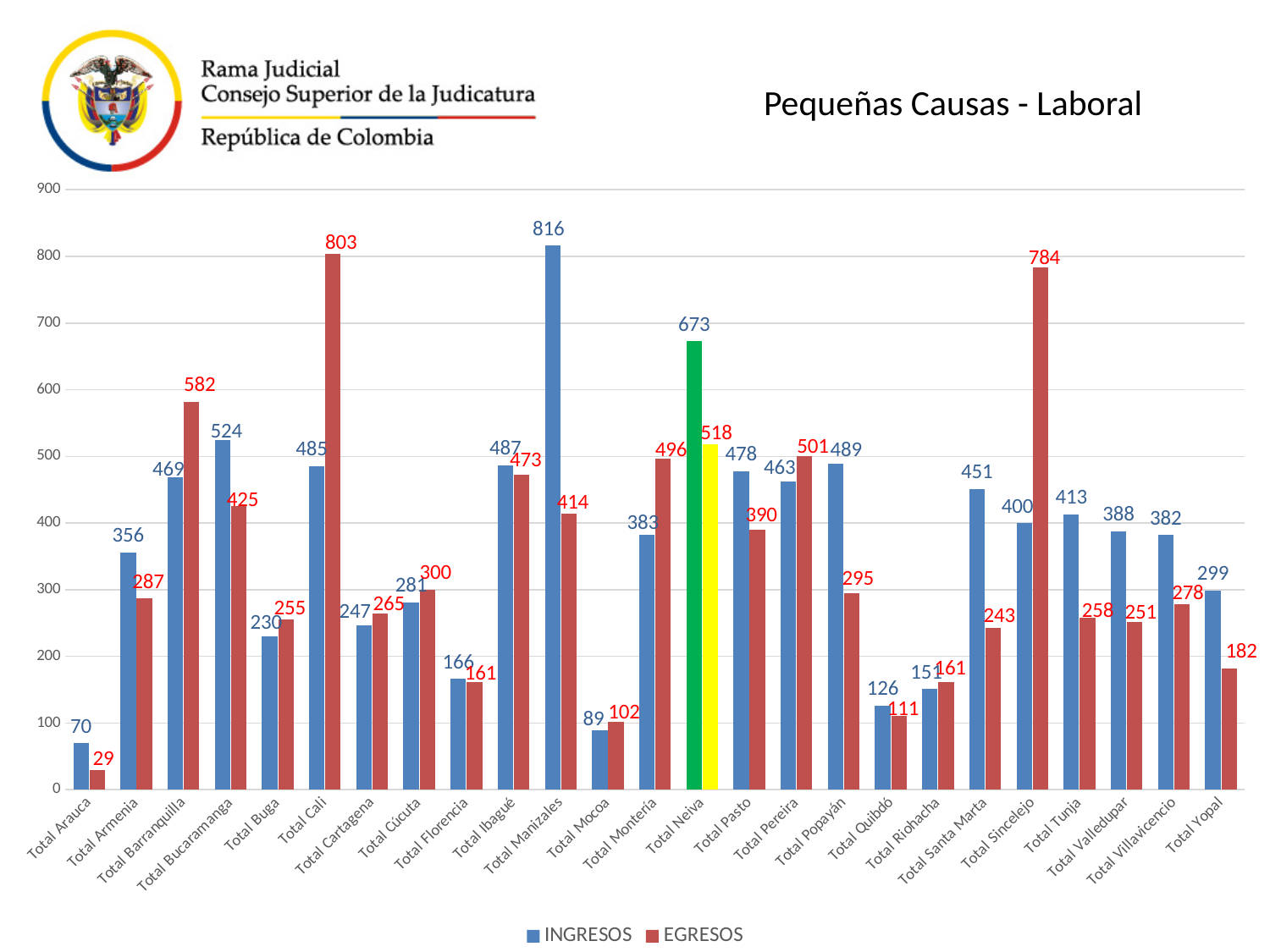
Which category has the lowest EGRESOS value? Total Arauca Which is larger for Total Barranquilla, INGRESOS or EGRESOS? EGRESOS What is the difference between EGRESOS and INGRESOS for Total Sincelejo? 384 What is the INGRESOS value for Total Neiva? 673 How many categories are shown on the x axis? 25 What kind of chart is shown on the slide? Bar chart Which category has the highest EGRESOS value? Total Cali What is the EGRESOS value for Total Cali? 803 How many series does the legend list? 2 What is the INGRESOS value for Total Manizales? 816 What is the title of the chart? Pequeñas Causas - Laboral Which category has the highest INGRESOS value? Total Manizales